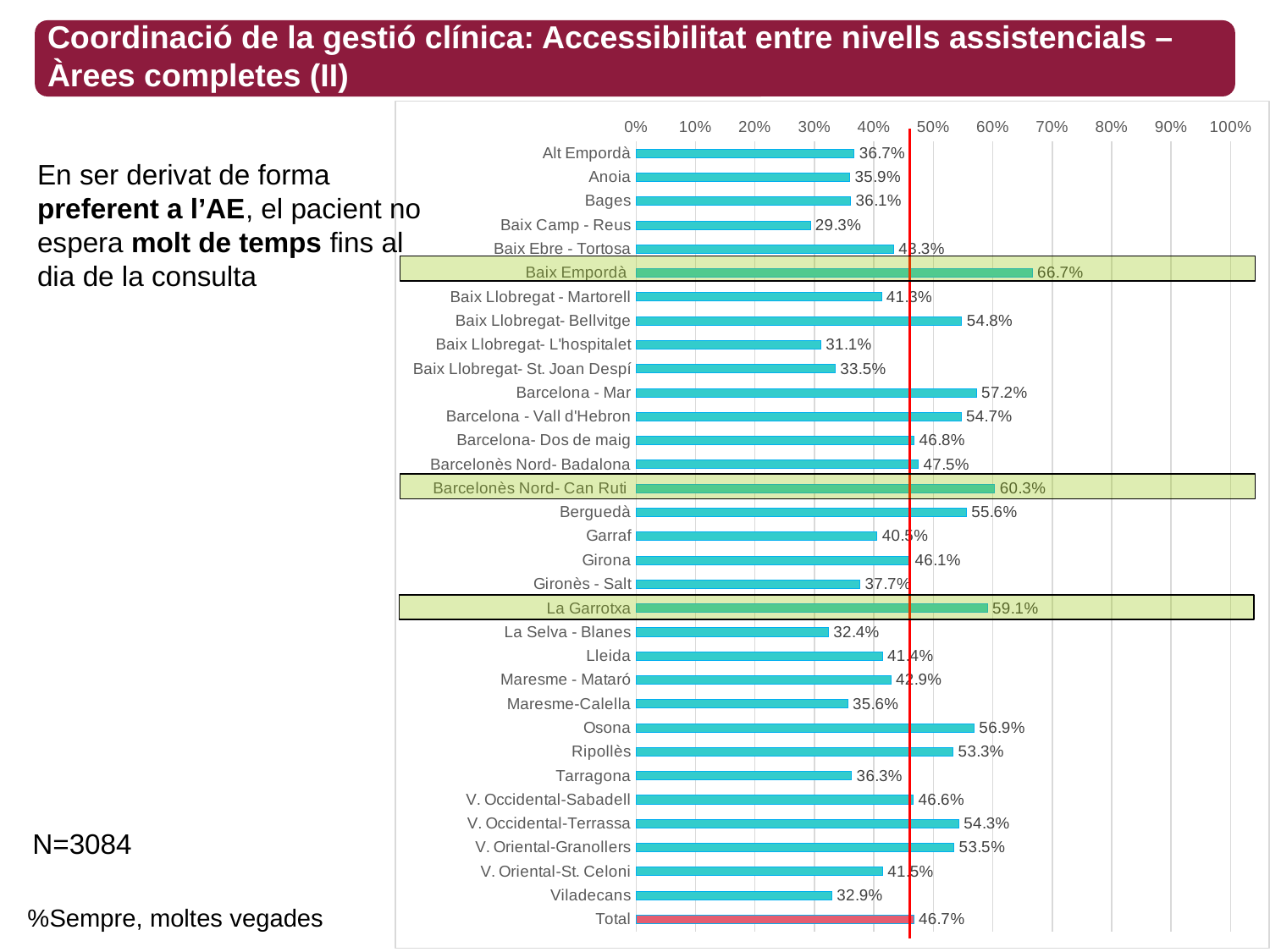
Is the value for Viladecans greater or less than 40%? less Which is larger, the value for Osona or the value for Ripollès? Osona What is the value for Barcelonès Nord- Can Ruti? 60.3% How many categories are shown on the chart, including Total? 33 What is the value for Baix Empordà? 66.7% What is the value for Total? 46.7% Which category has the highest value? Baix Empordà What is the difference between the values for Baix Empordà and Baix Camp - Reus? 37.4% What is the sample size (N) stated on the slide? N=3084 What is the value for La Garrotxa? 59.1% Which category has the lowest value? Baix Camp - Reus What kind of chart is shown on the slide? bar chart